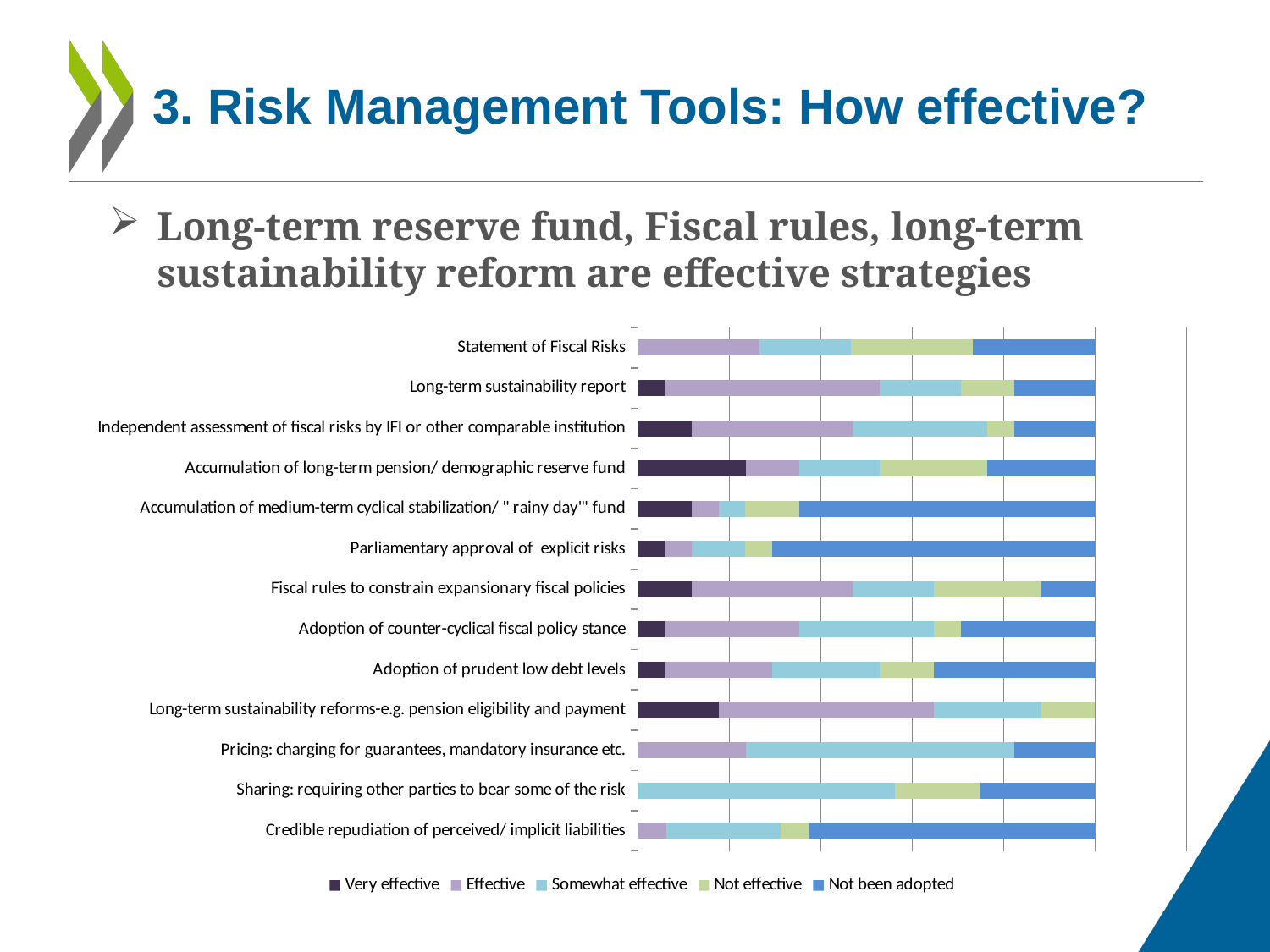
What kind of chart is shown on the slide? Stacked horizontal bar chart How many risk management tools (categories) are plotted in the chart? 13 What are the five response categories listed in the chart legend? Very effective, Effective, Somewhat effective, Not effective, Not been adopted Is the 'Very effective' segment larger for 'Long-term sustainability reforms' or for 'Long-term sustainability report'? Long-term sustainability reforms Which category has the largest 'Very effective' segment? Accumulation of long-term pension/ demographic reserve fund Is the 'Not been adopted' segment larger for 'Parliamentary approval of explicit risks' or for 'Fiscal rules to constrain expansionary fiscal policies'? Parliamentary approval of explicit risks Which category has no 'Not been adopted' segment at all? Long-term sustainability reforms-e.g. pension eligibility and payment Which category has the largest 'Somewhat effective' segment? Pricing: charging for guarantees, mandatory insurance etc. Which category has the largest 'Not been adopted' segment? Parliamentary approval of explicit risks Which category is listed at the top of the chart? Statement of Fiscal Risks How many series does the chart legend list? 5